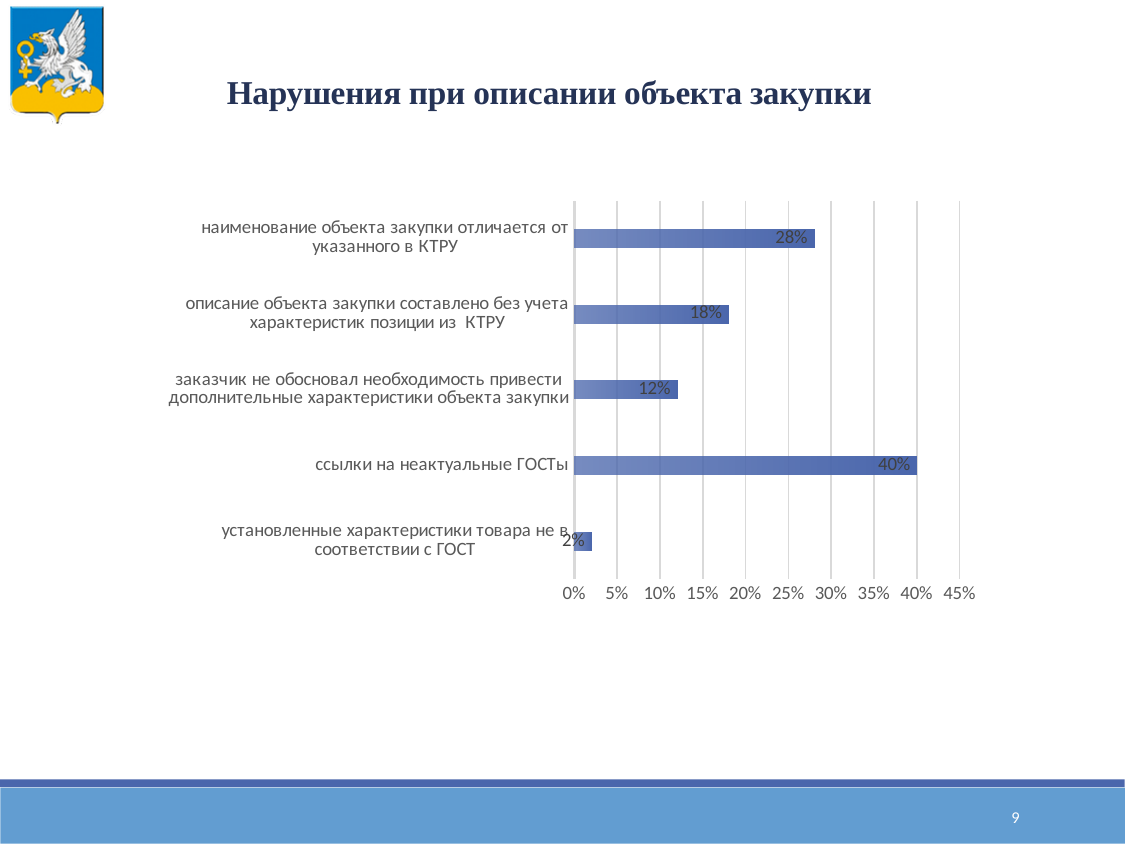
What kind of chart is shown on the slide? bar chart What is the difference between the values for "ссылки на неактуальные ГОСТы" and "наименование объекта закупки отличается от указанного в КТРУ"? 12% What is the value for "наименование объекта закупки отличается от указанного в КТРУ"? 28% What is the value for "ссылки на неактуальные ГОСТы"? 40% Which category has the highest value? ссылки на неактуальные ГОСТы How many categories are shown in the chart? 5 Which is larger: the value for "описание объекта закупки составлено без учета характеристик позиции из КТРУ" or for "заказчик не обосновал необходимость привести дополнительные характеристики объекта закупки"? описание объекта закупки составлено без учета характеристик позиции из КТРУ Is the value for "заказчик не обосновал необходимость привести дополнительные характеристики объекта закупки" greater or less than 20%? less What is the value for "описание объекта закупки составлено без учета характеристик позиции из КТРУ"? 18% What is the value for "установленные характеристики товара не в соответствии с ГОСТ"? 2% What is the title of the slide? Нарушения при описании объекта закупки Which category has the lowest value? установленные характеристики товара не в соответствии с ГОСТ